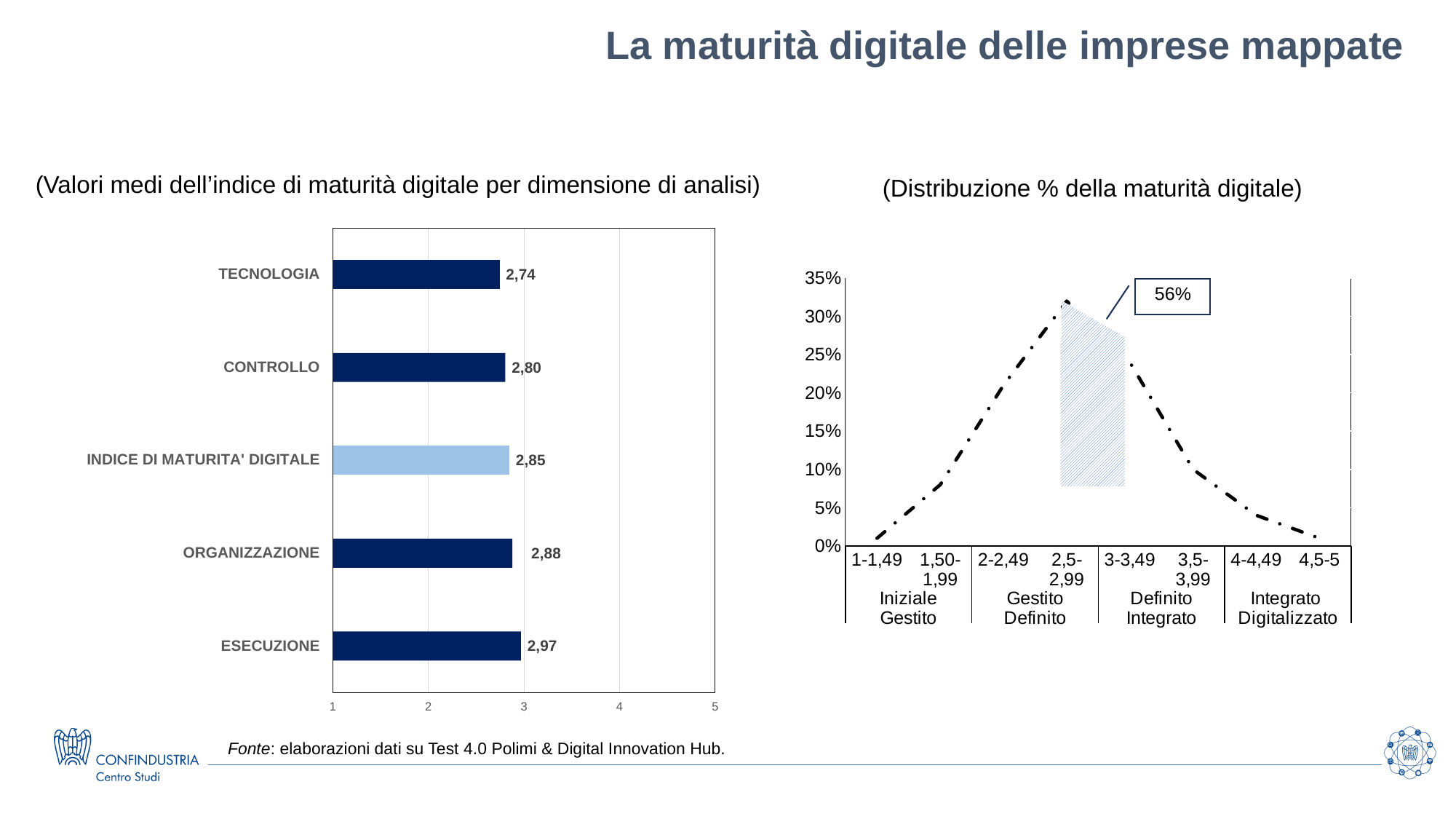
In the left chart (Valori medi dell'indice di maturità digitale per dimensione di analisi), what is the difference between ESECUZIONE and TECNOLOGIA? 0,23 In the left chart (Valori medi dell'indice di maturità digitale per dimensione di analisi), what is the value for INDICE DI MATURITA' DIGITALE? 2,85 What kind of chart is the left chart (Valori medi dell'indice di maturità digitale per dimensione di analisi)? Bar chart In the left chart (Valori medi dell'indice di maturità digitale per dimensione di analisi), what is the value for ESECUZIONE? 2,97 In the left chart (Valori medi dell'indice di maturità digitale per dimensione di analisi), which category has the highest value? ESECUZIONE In the right chart (Distribuzione % della maturità digitale), what percentage is shown in the annotation box for the shaded area? 56% In the right chart (Distribuzione % della maturità digitale), is the value for the 2,5-2,99 range greater or less than 25%? greater In the left chart (Valori medi dell'indice di maturità digitale per dimensione di analisi), which bar is shown in a lighter blue colour than the others? INDICE DI MATURITA' DIGITALE In the left chart (Valori medi dell'indice di maturità digitale per dimensione di analisi), what is the value for TECNOLOGIA? 2,74 In the left chart (Valori medi dell'indice di maturità digitale per dimensione di analisi), which category has the lowest value? TECNOLOGIA In the left chart (Valori medi dell'indice di maturità digitale per dimensione di analisi), how many categories are shown? 5 In the left chart (Valori medi dell'indice di maturità digitale per dimensione di analisi), which is larger, CONTROLLO or ORGANIZZAZIONE? ORGANIZZAZIONE